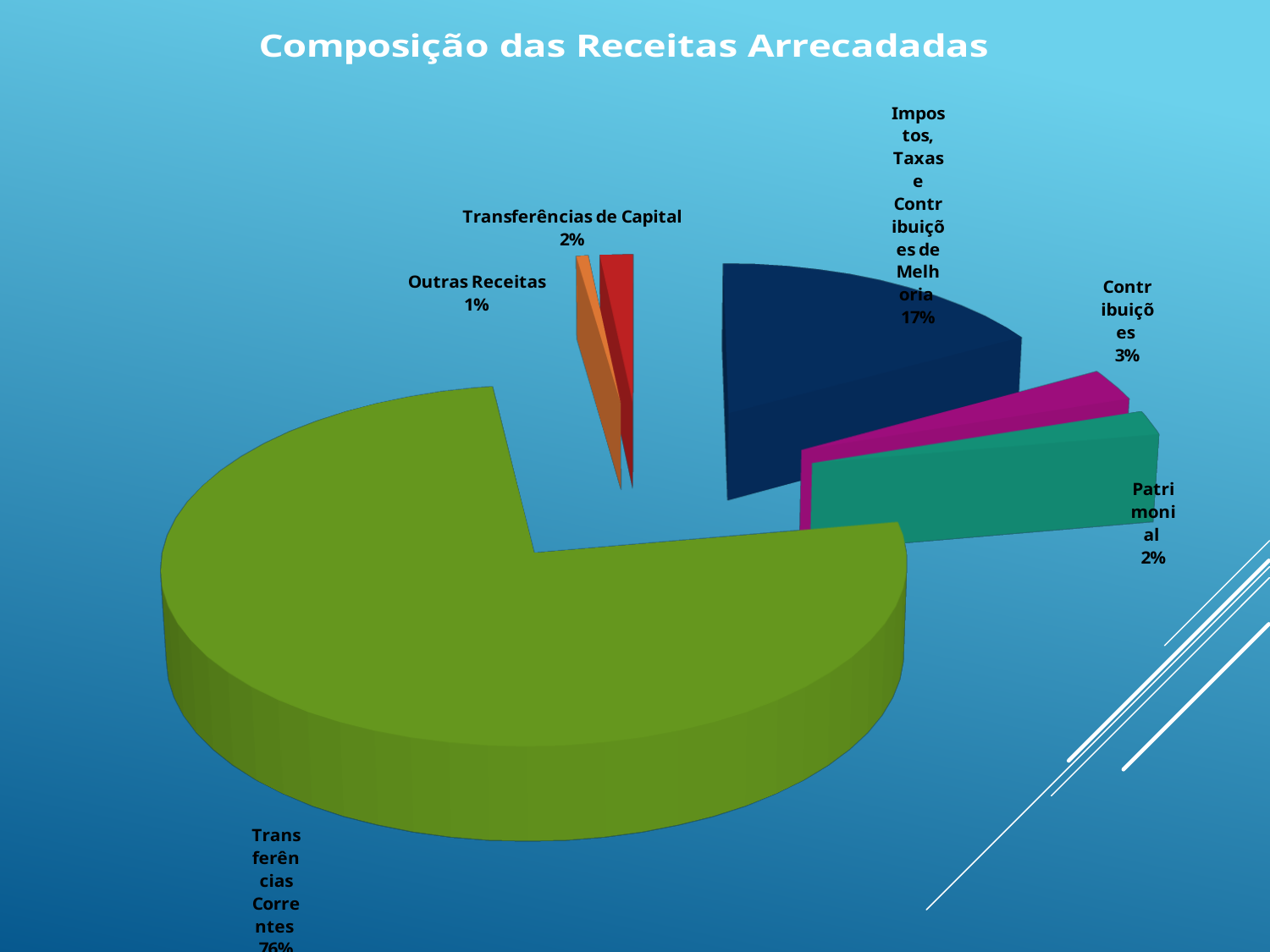
What is the difference between the shares of Transferências Correntes and Impostos, Taxas e Contribuições de Melhoria? 59% How many slices does the pie chart have? 6 Which category has the largest slice of the pie? Transferências Correntes Which category has the smallest slice of the pie? Outras Receitas What is the title of the chart? Composição das Receitas Arrecadadas What share of the pie does Impostos, Taxas e Contribuições de Melhoria represent? 17% What is the value shown for Patrimonial? 2% What is the value shown for Outras Receitas? 1% What is the value shown for Contribuições? 3% What share of the pie does Transferências Correntes represent? 76% Which is larger, the share for Contribuições or the share for Transferências de Capital? Contribuições What kind of chart is shown on the slide? pie chart